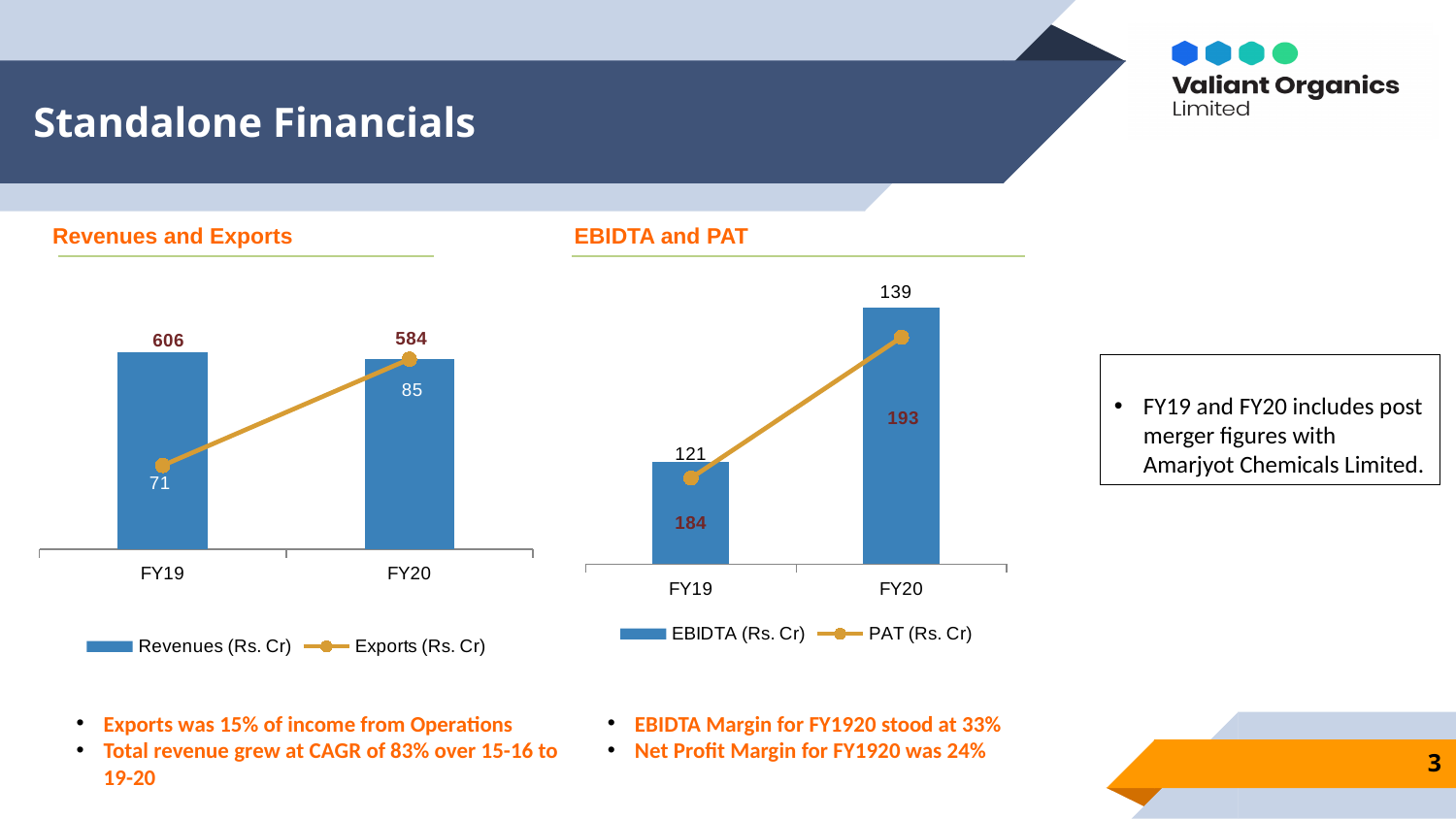
In the Revenues and Exports chart, which year has the higher Revenues value? FY19 In the EBIDTA and PAT chart, what is the value of PAT (Rs. Cr) for FY19? 121 In the EBIDTA and PAT chart, what is the value of EBIDTA (Rs. Cr) for FY20? 193 In the Revenues and Exports chart, what is the difference between Revenues in FY19 and FY20? 22 In the Revenues and Exports chart, what is the value of Revenues (Rs. Cr) for FY19? 606 In the EBIDTA and PAT chart, how many series does the legend list? 2 In the EBIDTA and PAT chart, which year has the lower EBIDTA value? FY19 In the Revenues and Exports chart, do Exports rise or fall from FY19 to FY20? rise In the EBIDTA and PAT chart, what is the difference between PAT in FY20 and FY19? 18 How many categories are shown on the x axis of the EBIDTA and PAT chart? 2 In the Revenues and Exports chart, what is the value of Exports (Rs. Cr) for FY20? 85 What kind of chart is the Revenues and Exports chart? Combined bar and line chart